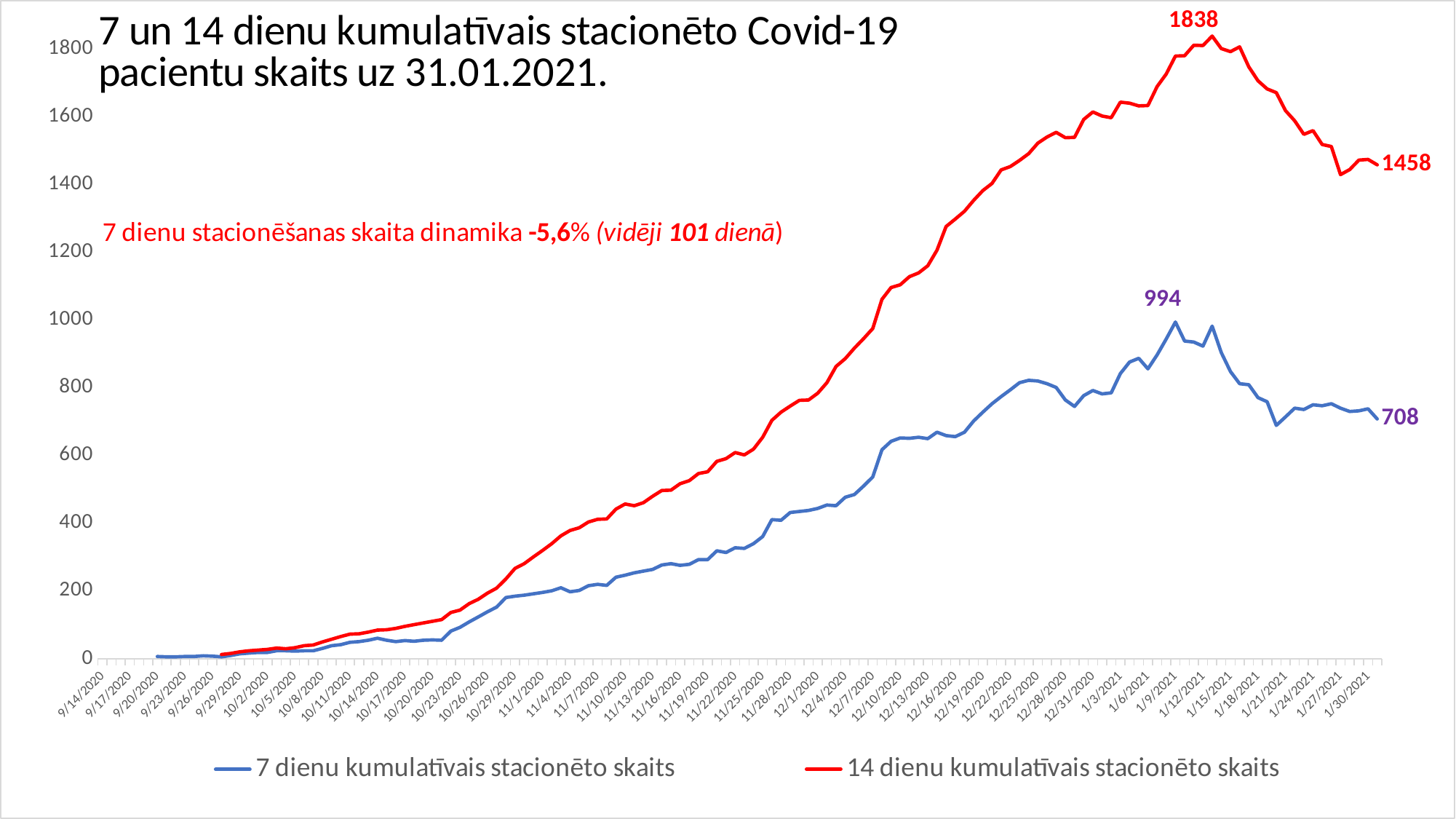
Does the 7 dienu kumulatīvais stacionēto skaits line rise or fall between 1/15/2021 and 1/30/2021? fall What colour is the 14 dienu kumulatīvais stacionēto skaits line? red Which series reaches the higher peak, the 7 dienu or the 14 dienu kumulatīvais stacionēto skaits? 14 dienu kumulatīvais stacionēto skaits What is the difference between the labelled peak (1838) and the final labelled value (1458) of the 14 dienu series? 380 Is the value of the 14 dienu kumulatīvais stacionēto skaits line on 12/13/2020 greater or less than 1000? greater What kind of chart is shown on the slide? line chart What is the difference between the labelled peak (994) and the final labelled value (708) of the 7 dienu series? 286 How many series does the legend list? 2 What is the peak value labelled on the 14 dienu kumulatīvais stacionēto skaits line? 1838 What is the final value labelled on the 14 dienu kumulatīvais stacionēto skaits line? 1458 What is the final value labelled on the 7 dienu kumulatīvais stacionēto skaits line? 708 What is the peak value labelled on the 7 dienu kumulatīvais stacionēto skaits line? 994